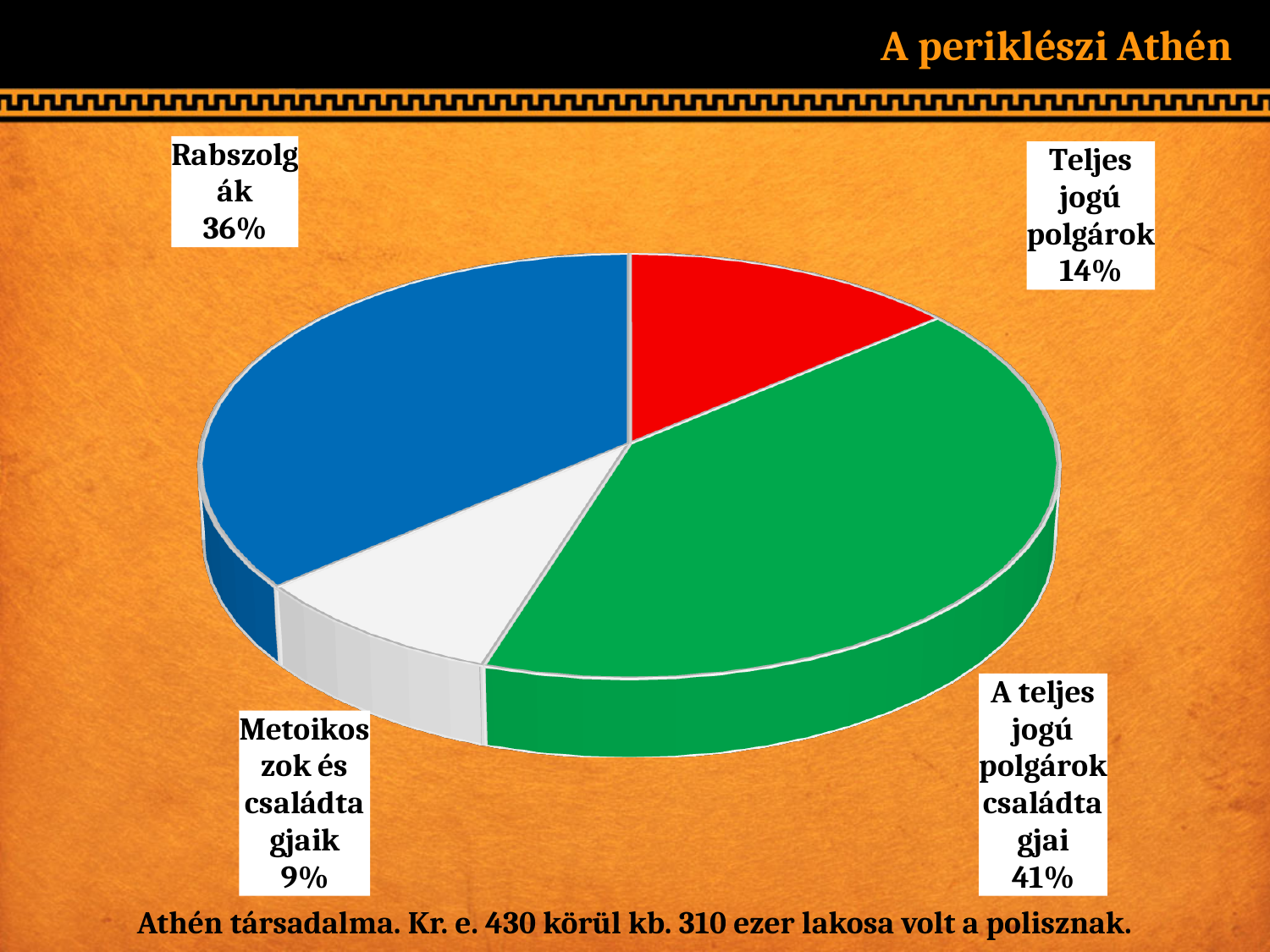
What kind of chart is shown on the slide? pie chart How many slices does the pie chart have? 4 Which category has the largest slice of the pie? A teljes jogú polgárok családtagjai What is the difference in percentage points between the Rabszolgák slice and the Teljes jogú polgárok slice? 22 Which is larger, the Rabszolgák slice or the Metoikoszok és családtagjaik slice? Rabszolgák What percentage of the pie is labelled Rabszolgák? 36% What colour is the Rabszolgák slice of the pie? blue Which category has the smallest slice of the pie? Metoikoszok és családtagjaik What percentage of the pie is labelled Teljes jogú polgárok? 14% What percentage of the pie is labelled Metoikoszok és családtagjaik? 9% What percentage of the pie is labelled A teljes jogú polgárok családtagjai? 41% What colour is the Teljes jogú polgárok slice of the pie? red